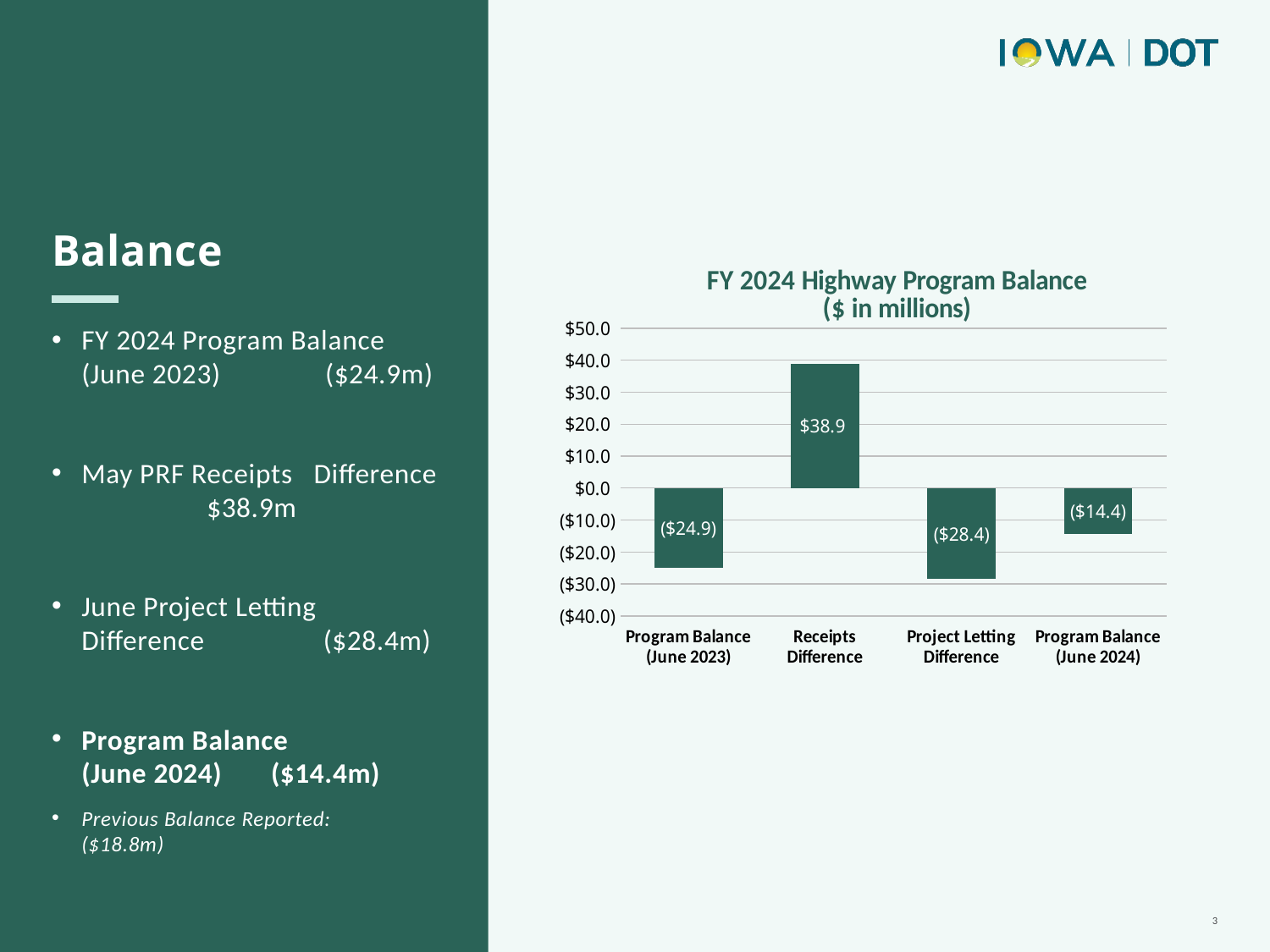
What is the value for Project Letting Difference in the chart? ($28.4) How many categories are shown in the chart? 4 Which is larger in the chart: the value for Program Balance (June 2023) or the value for Program Balance (June 2024)? Program Balance (June 2024) Is the value for Receipts Difference greater or less than $30.0? greater What is the title of the chart? FY 2024 Highway Program Balance ($ in millions) What is the value for Receipts Difference in the FY 2024 Highway Program Balance chart? $38.9 Which category has the lowest value in the chart? Project Letting Difference What is the value for Program Balance (June 2023) in the chart? ($24.9) What kind of chart is shown on the slide? Bar chart Is the value for Project Letting Difference greater or less than ($20.0)? less Which category has the highest value in the chart? Receipts Difference What is the value for Program Balance (June 2024) in the chart? ($14.4)